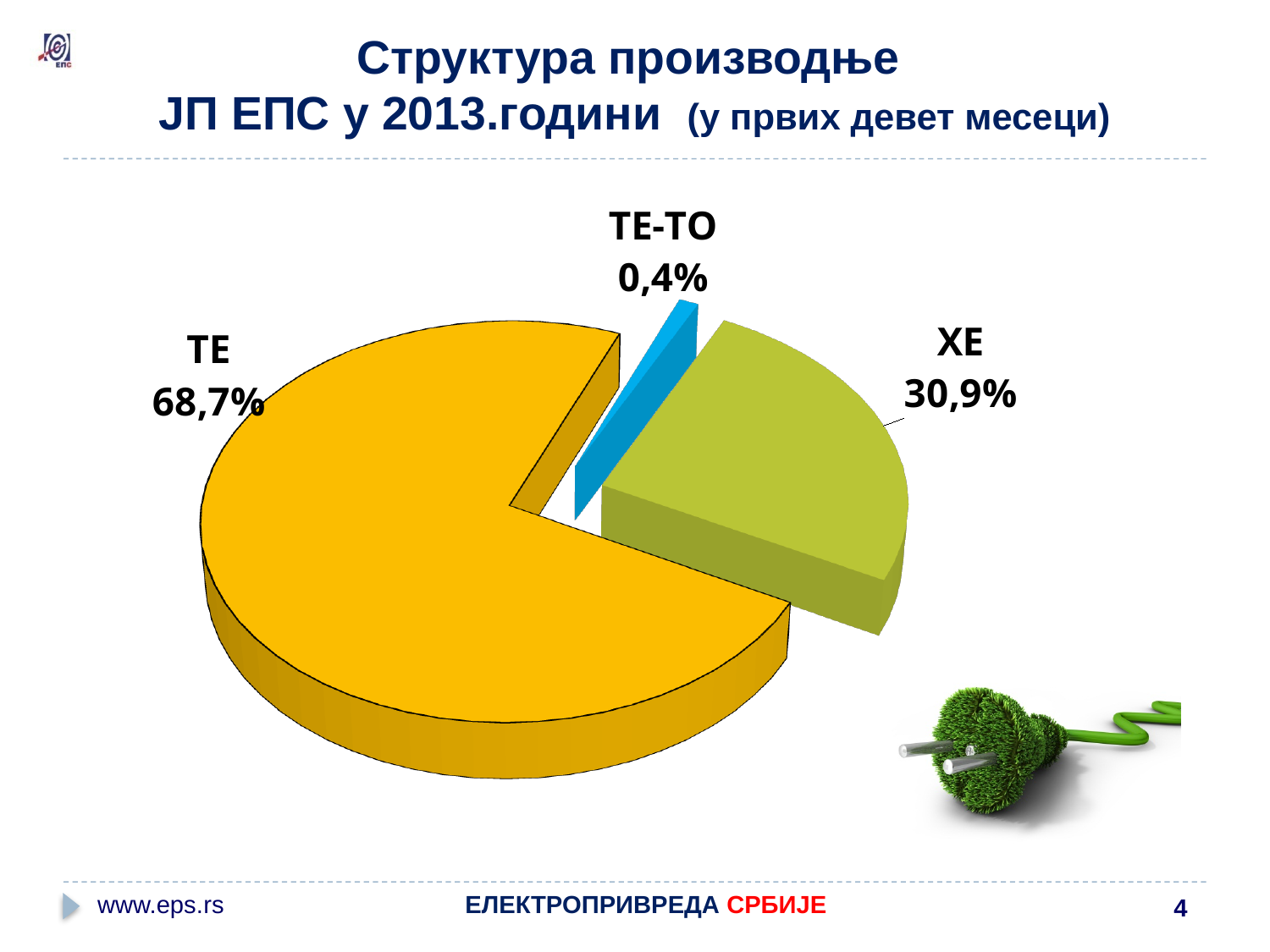
How many slices does the pie chart have? 3 Which is larger, the share for ХЕ or the share for ТЕ-ТО? ХЕ What share of production does ХЕ account for? 30,9% What colour is the ТЕ-ТО slice? Blue What share of production does ТЕ account for? 68,7% What kind of chart is shown on the slide? Pie chart What share of production does ТЕ-ТО account for? 0,4% What is the combined share of ХЕ and ТЕ-ТО? 31,3% What colour is the ХЕ slice? Green What is the difference in percentage points between the ТЕ and ХЕ shares? 37,8 Which category has the smallest share of the pie? ТЕ-ТО Which category has the largest share of the pie? ТЕ